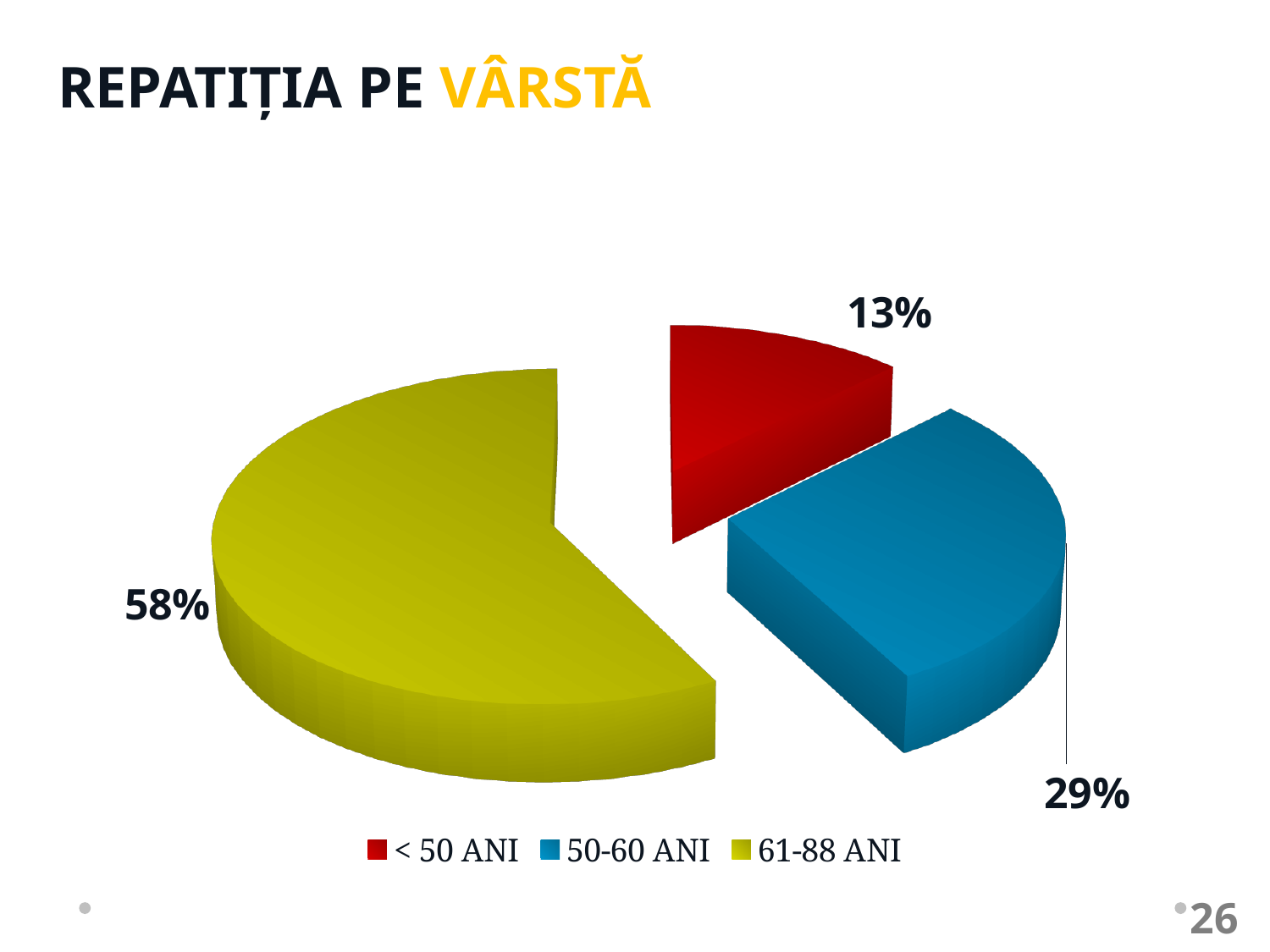
What kind of chart is shown on the slide? Pie chart What is the difference in percentage points between the 61-88 ANI and 50-60 ANI slices? 29 What colour is the 61-88 ANI slice? Yellow-green Which age group has the largest share of the pie? 61-88 ANI What share of the pie does the < 50 ANI slice represent? 13% What is the difference in percentage points between the 50-60 ANI and < 50 ANI slices? 16 How many slices does the pie chart have? 3 Which slice is larger, 50-60 ANI or < 50 ANI? 50-60 ANI What share of the pie does the 50-60 ANI slice represent? 29% What is the title of the slide? REPATIȚIA PE VÂRSTĂ What share of the pie does the 61-88 ANI slice represent? 58% Which age group has the smallest share of the pie? < 50 ANI